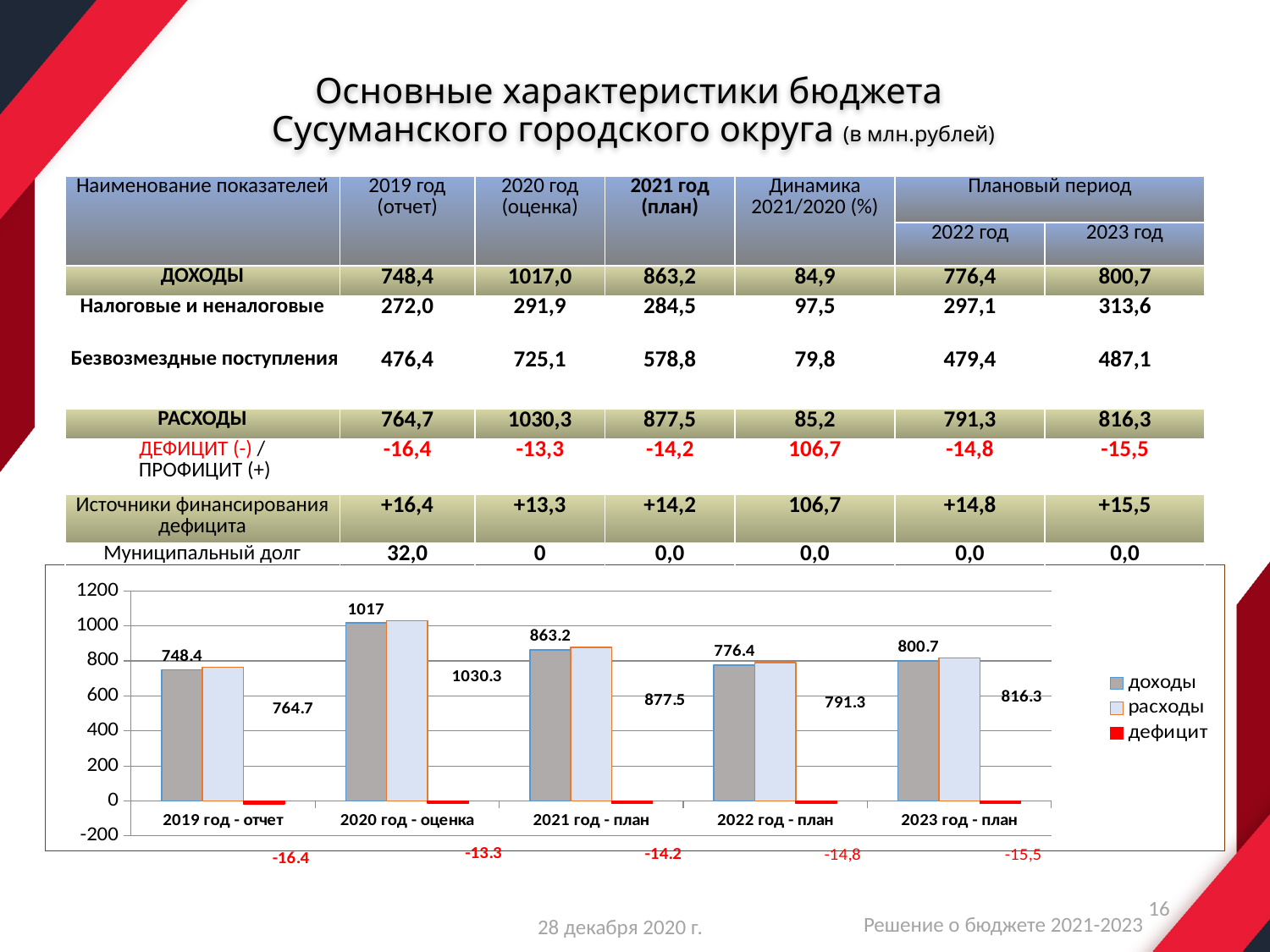
Which year category has the lowest расходы value in the chart? 2019 год - отчет What is the value of расходы for 2021 год - план in the chart? 877.5 Which series in the chart is shown in red? дефицит Is the доходы value for 2021 год - план greater or less than 800? greater What is the value of доходы for 2020 год - оценка in the chart? 1017 How many series does the chart legend list? 3 Which year category has the highest доходы value in the chart? 2020 год - оценка In the chart, which is larger for 2022 год - план: доходы or расходы? расходы What type of chart is shown at the bottom of the slide? bar chart How many year categories are shown on the chart's x axis? 5 In the chart, what is the difference between расходы and доходы for 2023 год - план? 15.6 What is the value of дефицит for 2019 год - отчет in the chart? -16.4